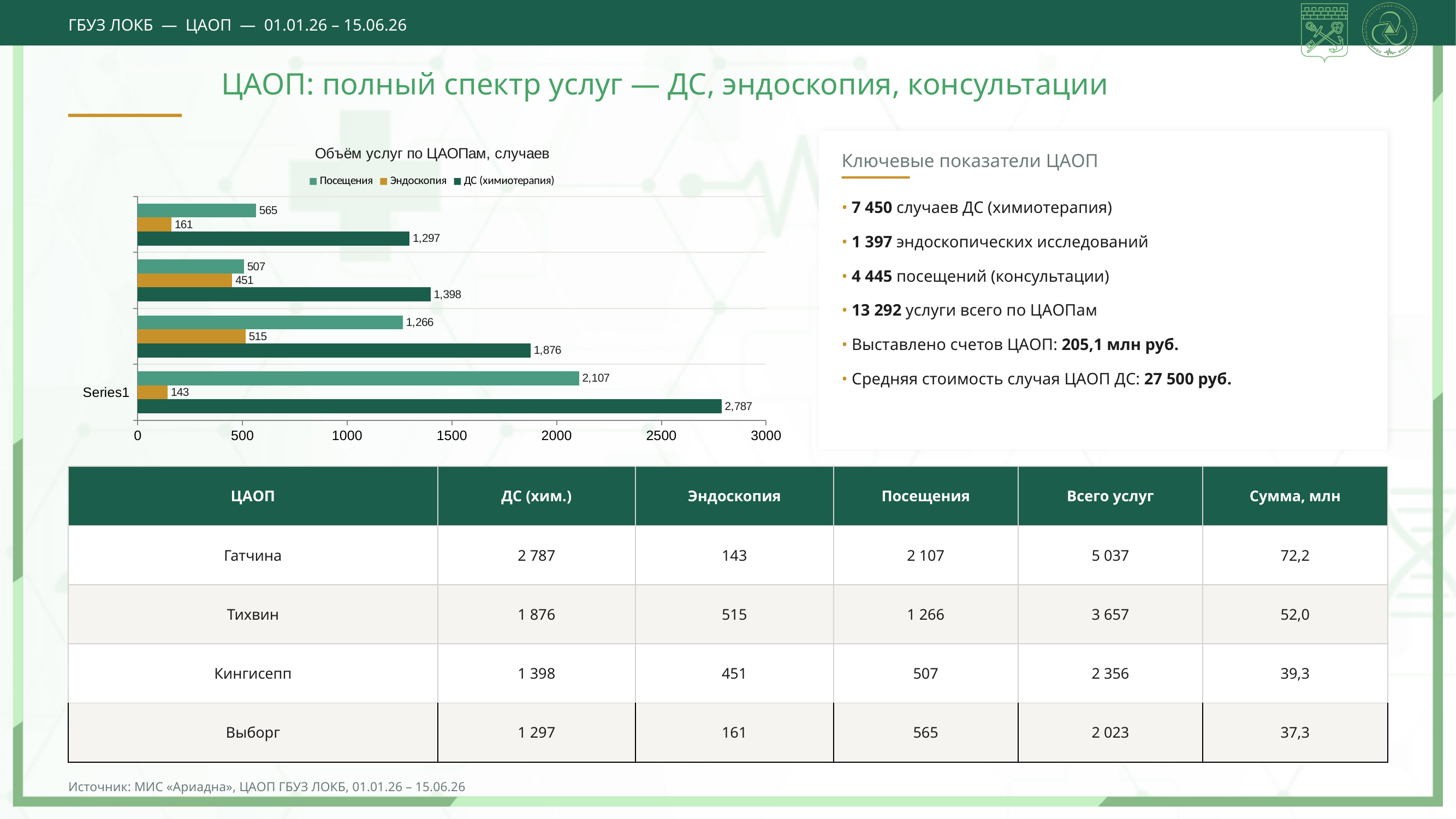
Is the ДС (химиотерапия) value for the group labelled Series1 greater or less than 2500? greater How many groups of bars are plotted in the chart "Объём услуг по ЦАОПам, случаев"? 4 What is the highest value among the Эндоскопия bars in the chart? 515 In the chart, what is the value of Посещения for the group labelled Series1? 2,107 How many series does the legend of the chart "Объём услуг по ЦАОПам, случаев" list? 3 What is the largest value shown on any bar in the chart "Объём услуг по ЦАОПам, случаев"? 2,787 In the chart, what is the value of ДС (химиотерапия) for the group labelled Series1? 2,787 What kind of chart is shown under the title "Объём услуг по ЦАОПам, случаев"? bar chart In the chart, what is the value of Эндоскопия for the group labelled Series1? 143 What is the smallest value shown on any bar in the chart "Объём услуг по ЦАОПам, случаев"? 143 In the group labelled Series1, what is the difference between the ДС (химиотерапия) value and the Посещения value? 680 In the group labelled Series1, which is larger: Посещения or Эндоскопия? Посещения